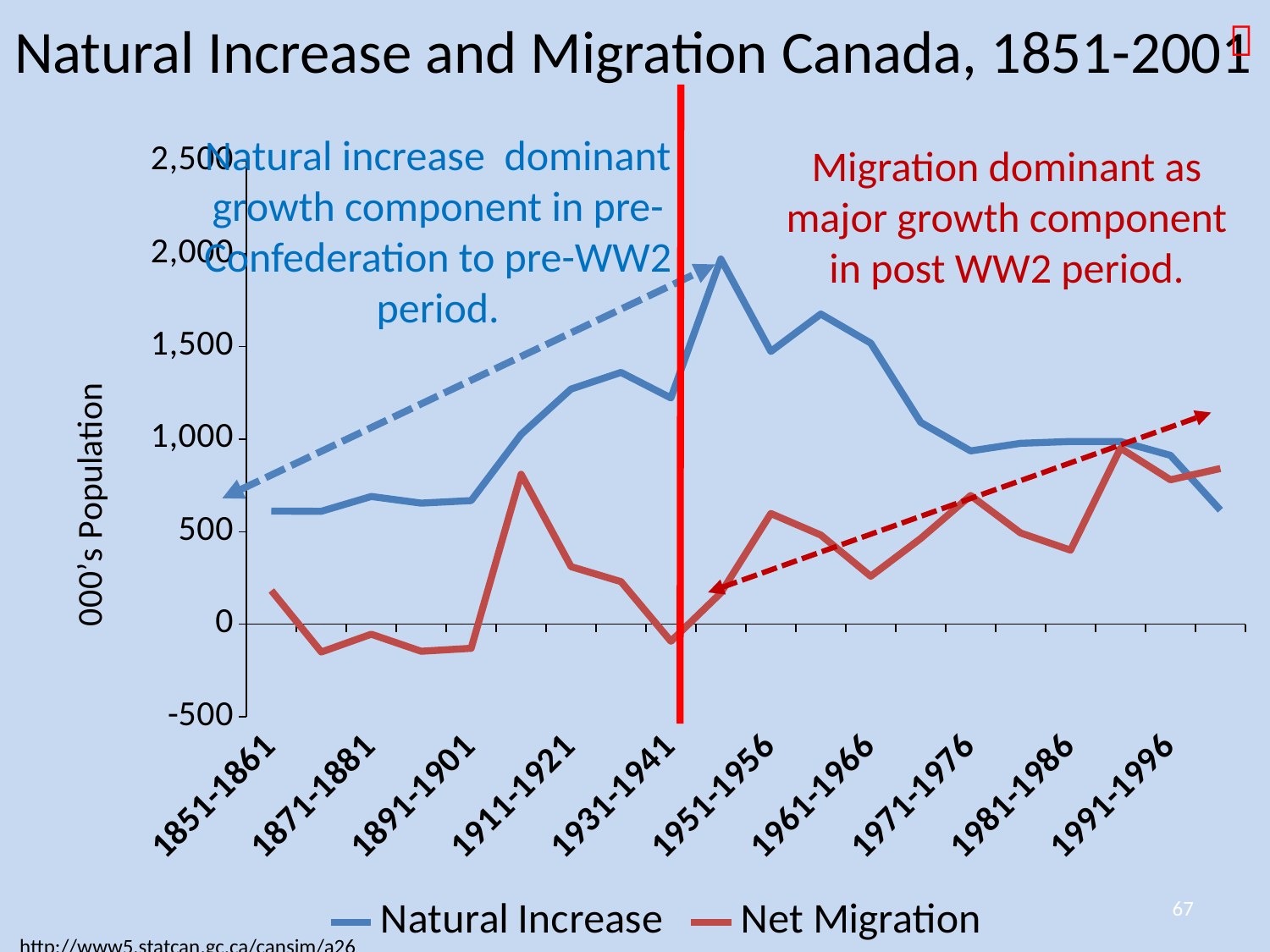
Does the Net Migration series generally rise or fall from 1951-1956 to 1991-1996? rise How many series does the legend list? 2 What is the label on the vertical axis? 000's Population Is the Natural Increase value for 1951-1956 greater or less than 1,000? greater Which series has the larger value for 1851-1861, Natural Increase or Net Migration? Natural Increase Is the Natural Increase value for 1851-1861 greater or less than 500? greater Is the Net Migration value for 1911-1921 greater or less than 500? less What kind of chart is shown on the slide? line chart What is the title of the chart? Natural Increase and Migration Canada, 1851-2001 Which series has the larger value for 1971-1976, Natural Increase or Net Migration? Natural Increase How many period labels are shown on the x axis? 10